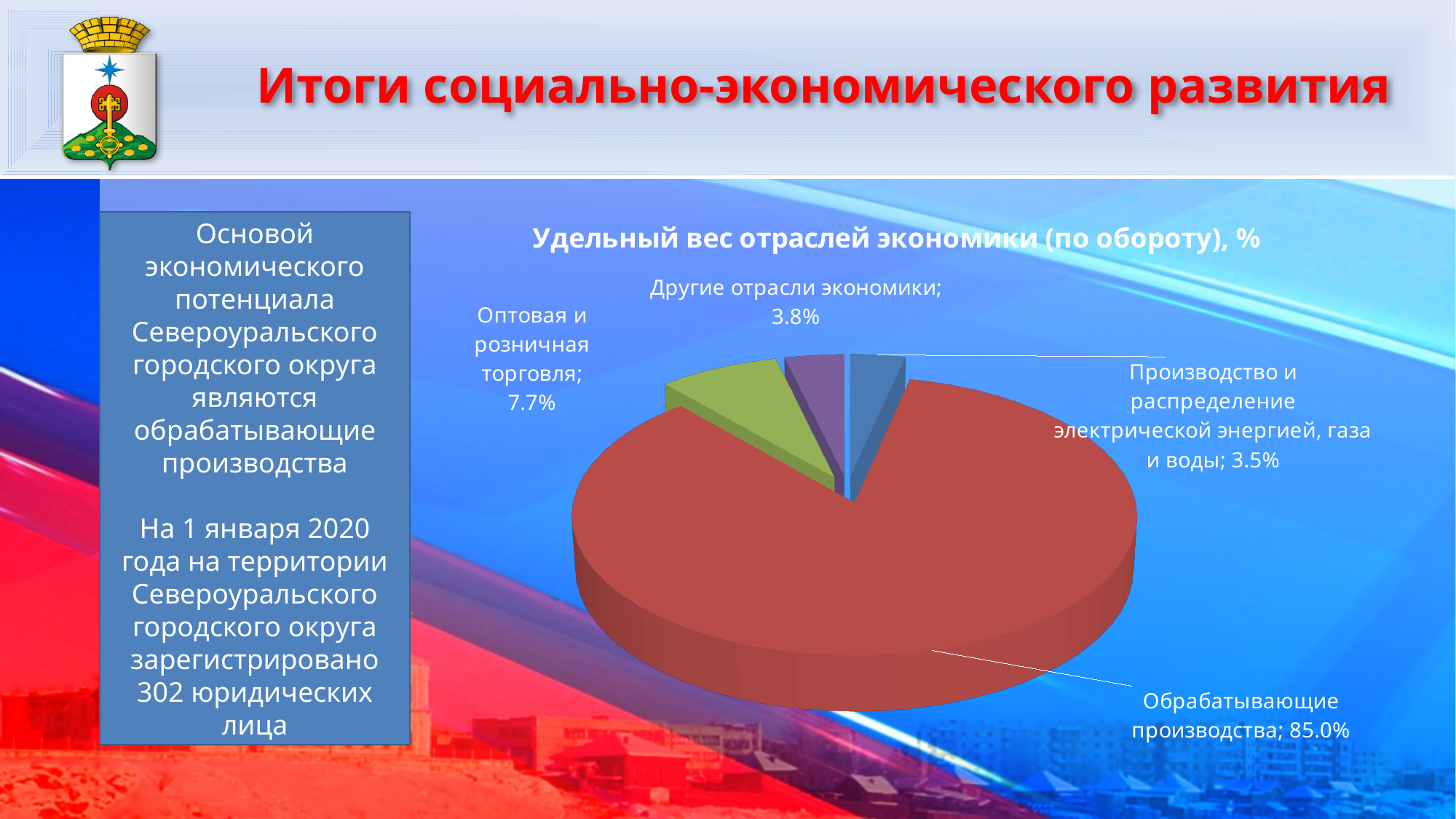
What is the share of Другие отрасли экономики in the pie chart? 3.8% Which sector has the smallest slice in the pie chart? Производство и распределение электрической энергии, газа и воды What is the difference in percentage points between Обрабатывающие производства and Оптовая и розничная торговля? 77.3 Which sector has the largest slice in the pie chart? Обрабатывающие производства What is the share of Обрабатывающие производства in the pie chart? 85.0% What is the share of Производство и распределение электрической энергии, газа и воды in the pie chart? 3.5% What is the difference in percentage points between Другие отрасли экономики and Производство и распределение электрической энергии, газа и воды? 0.3 How many slices does the pie chart have? 4 What type of chart is shown on the slide? Pie chart Which is larger: the share of Оптовая и розничная торговля or the share of Другие отрасли экономики? Оптовая и розничная торговля What is the share of Оптовая и розничная торговля in the pie chart? 7.7% What is the title of the chart? Удельный вес отраслей экономики (по обороту), %